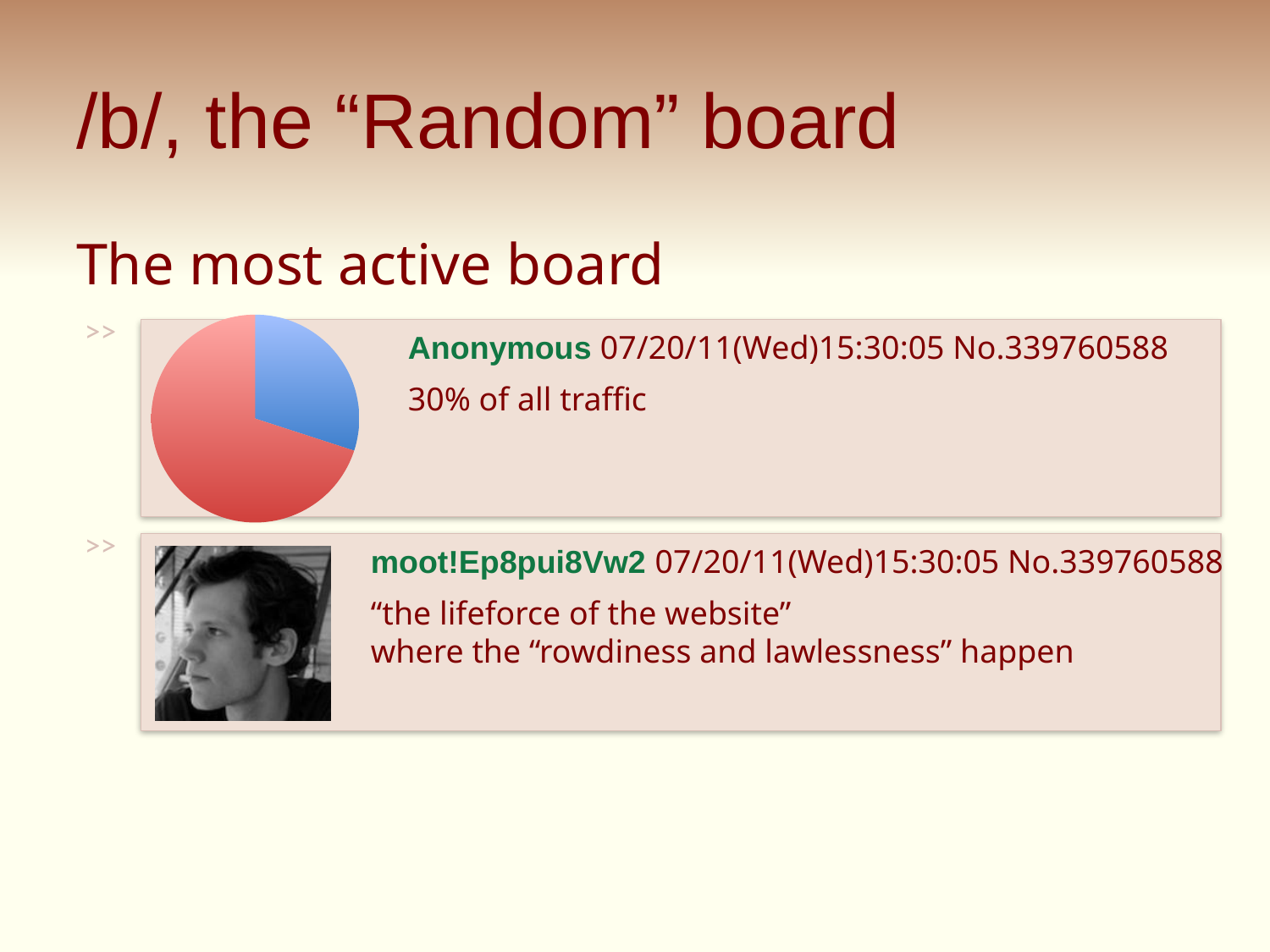
According to the text beside the pie chart, what share of all traffic does /b/ account for? 30% Which slice of the pie chart is larger, the red one or the blue one? red What kind of chart is shown on the slide? pie chart What colour is the larger slice of the pie chart? red How many slices does the pie chart have? 2 Does the red slice of the pie chart cover more or less than half of the pie? more Does the pie chart have a legend? no Which slice of the pie chart is the smallest? the blue slice